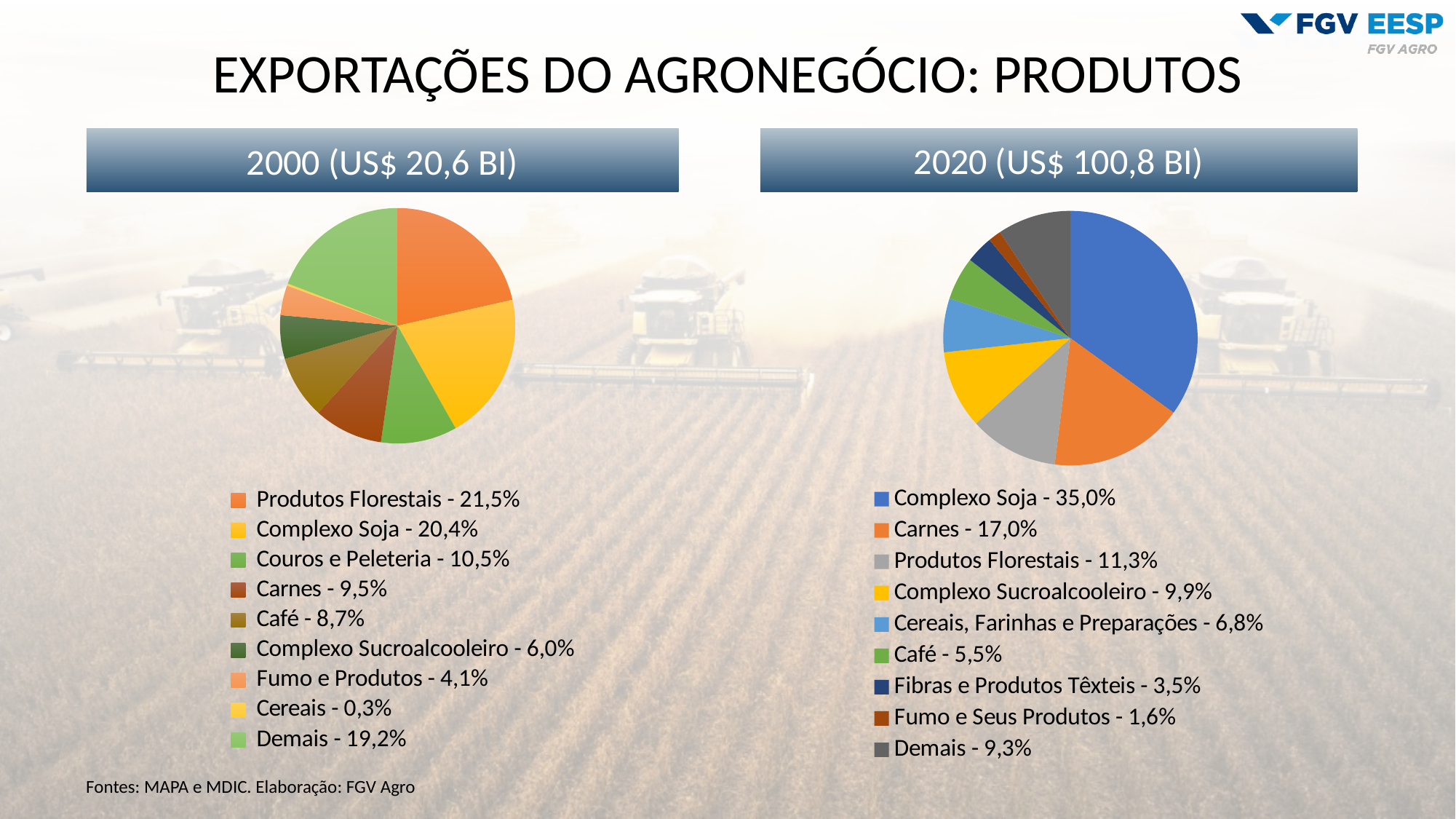
In the 2000 (US$ 20,6 BI) chart, which is larger: Carnes or Café? Carnes In the 2000 (US$ 20,6 BI) chart, which category has the smallest share? Cereais In the 2020 (US$ 100,8 BI) chart, what share does Carnes have? 17,0% In the 2000 (US$ 20,6 BI) chart, which category has the largest share? Produtos Florestais In the 2000 (US$ 20,6 BI) chart, what share does Complexo Soja have? 20,4% What type of chart is used for the 2000 (US$ 20,6 BI) data? Pie chart How many categories are listed in the legend of the 2020 (US$ 100,8 BI) chart? 9 In the 2020 (US$ 100,8 BI) chart, what share does Cereais, Farinhas e Preparações have? 6,8% In the 2020 (US$ 100,8 BI) chart, which category has the smallest share? Fumo e Seus Produtos In the 2000 (US$ 20,6 BI) chart, what is the difference in percentage points between Produtos Florestais and Demais? 2,3 In the 2020 (US$ 100,8 BI) chart, what colour is the Complexo Soja slice? Blue In the 2020 (US$ 100,8 BI) chart, what is the difference in percentage points between Complexo Soja and Carnes? 18,0